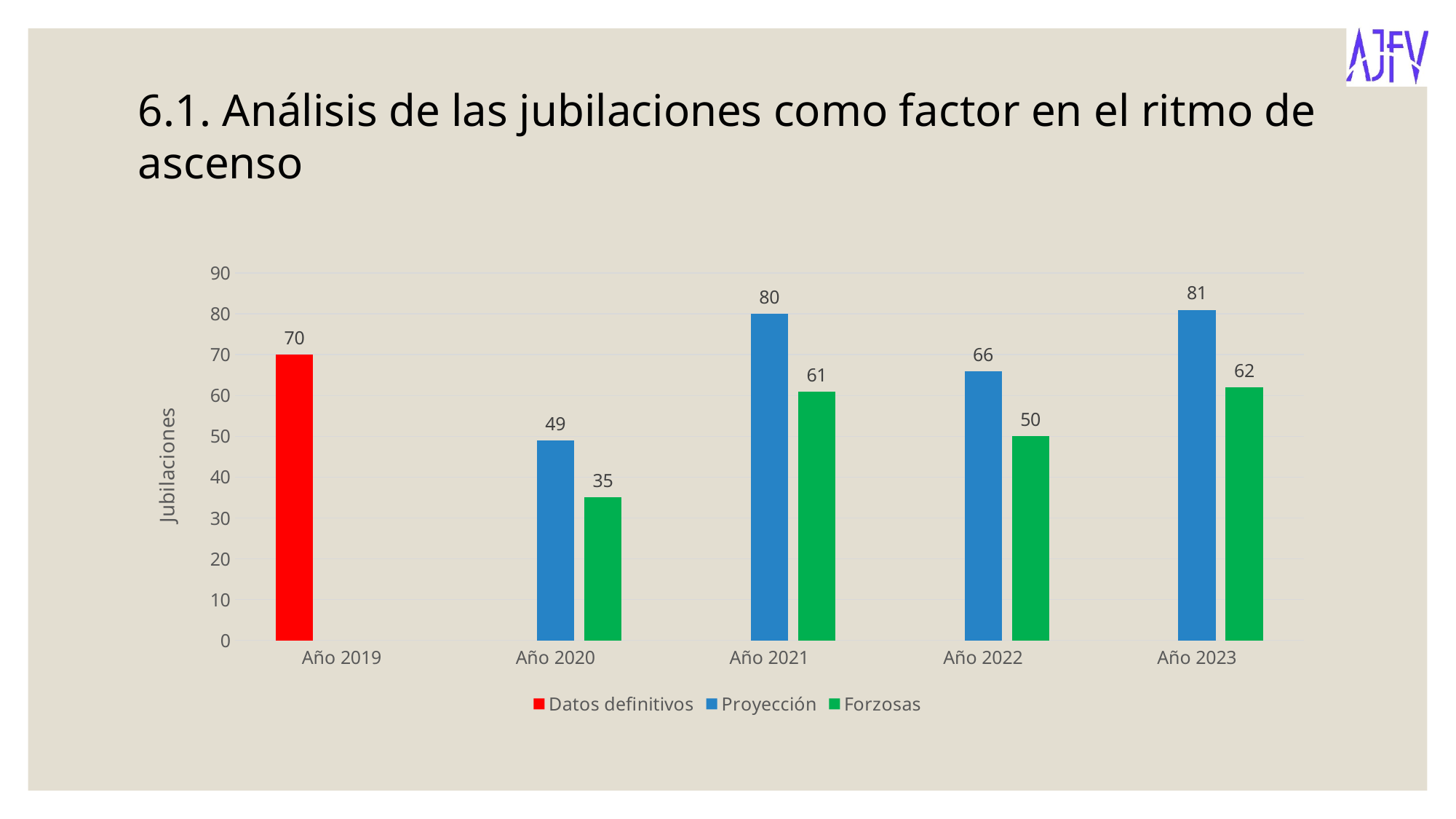
How many year categories are shown on the x axis? 5 What is the Proyección value for Año 2021? 80 What is the label of the vertical axis? Jubilaciones Which year has the highest Proyección value? Año 2023 What kind of chart is shown on the slide? Bar chart What is the Forzosas value for Año 2023? 62 How many series does the legend list? 3 Which is larger, the Proyección value for Año 2020 or the Forzosas value for Año 2021? Forzosas for Año 2021 What is the Forzosas value for Año 2020? 35 Which year has the lowest Forzosas value? Año 2020 What is the difference between the Proyección and Forzosas values for Año 2022? 16 What is the value of Datos definitivos for Año 2019? 70